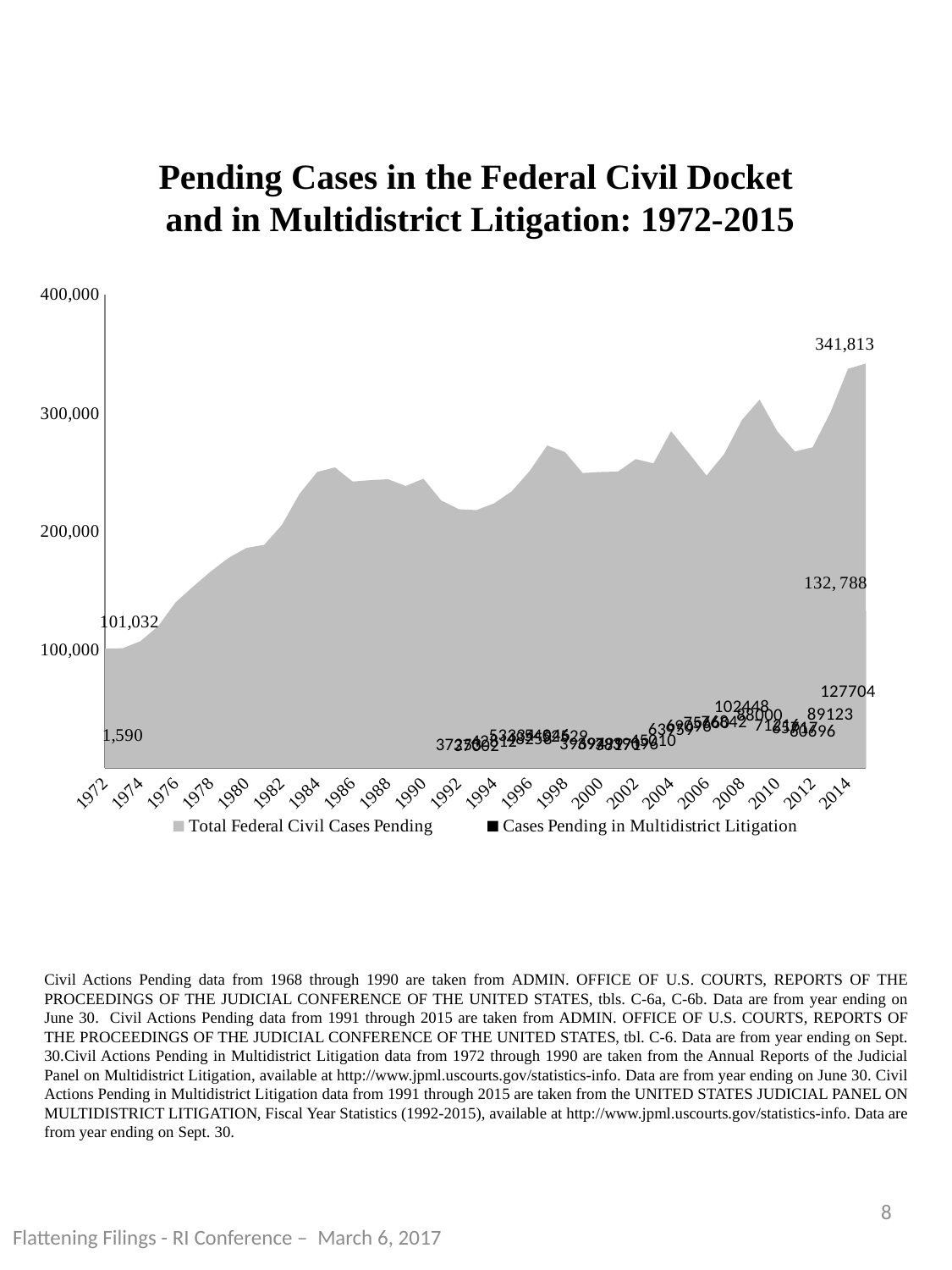
What kind of chart is shown on the slide? Area chart Is the value of Total Federal Civil Cases Pending in 1976 greater or less than 200,000? less By how much did Total Federal Civil Cases Pending increase from 1972 (101,032) to 2015 (341,813)? 240,781 What is the value of Total Federal Civil Cases Pending in 1972? 101,032 How many series does the legend list? 2 Is the value of Total Federal Civil Cases Pending in 1984 greater or less than 200,000? greater In which year does the Total Federal Civil Cases Pending series reach its highest value? 2015 What is the value of Cases Pending in Multidistrict Litigation in 1972? 1,590 Overall, do Total Federal Civil Cases Pending rise or fall from 1972 to 2015? Rise What is the value of Total Federal Civil Cases Pending in 2015? 341,813 What is the title of the chart? Pending Cases in the Federal Civil Docket and in Multidistrict Litigation: 1972-2015 What is the value of Cases Pending in Multidistrict Litigation in 2015? 132, 788